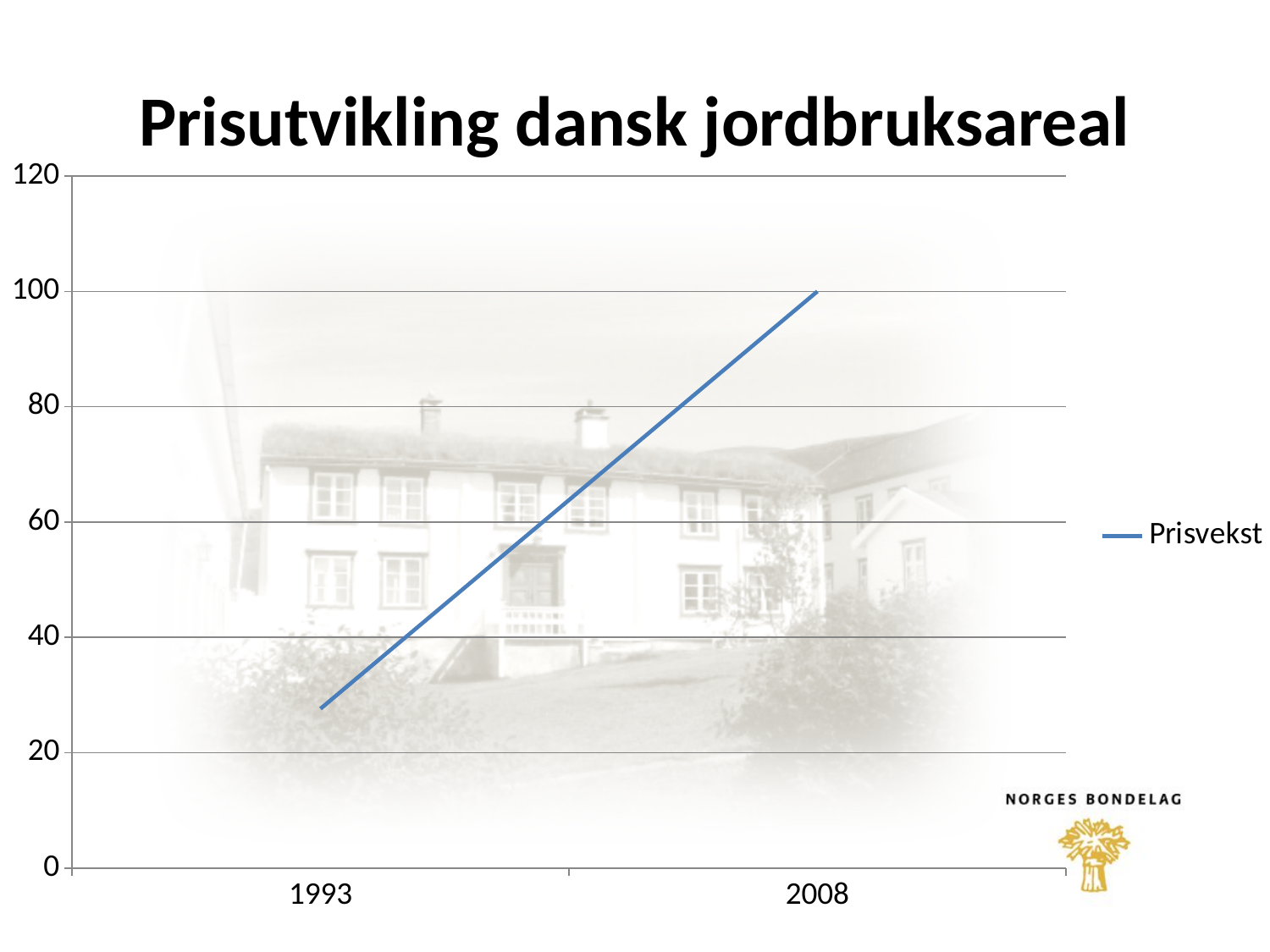
What is the title of the chart? Prisutvikling dansk jordbruksareal What kind of chart is shown on the slide? line chart Does the Prisvekst line rise or fall from 1993 to 2008? rise Which is larger, the Prisvekst value for 1993 or for 2008? 2008 Is the Prisvekst value for 1993 greater or less than 20? greater How many years are labelled on the x axis? 2 What is the Prisvekst value for 2008? 100 What is the name of the series shown in the legend? Prisvekst How many series does the legend list? 1 Is the Prisvekst value for 1993 greater or less than 40? less Which year has the lowest Prisvekst value? 1993 Which year has the highest Prisvekst value? 2008